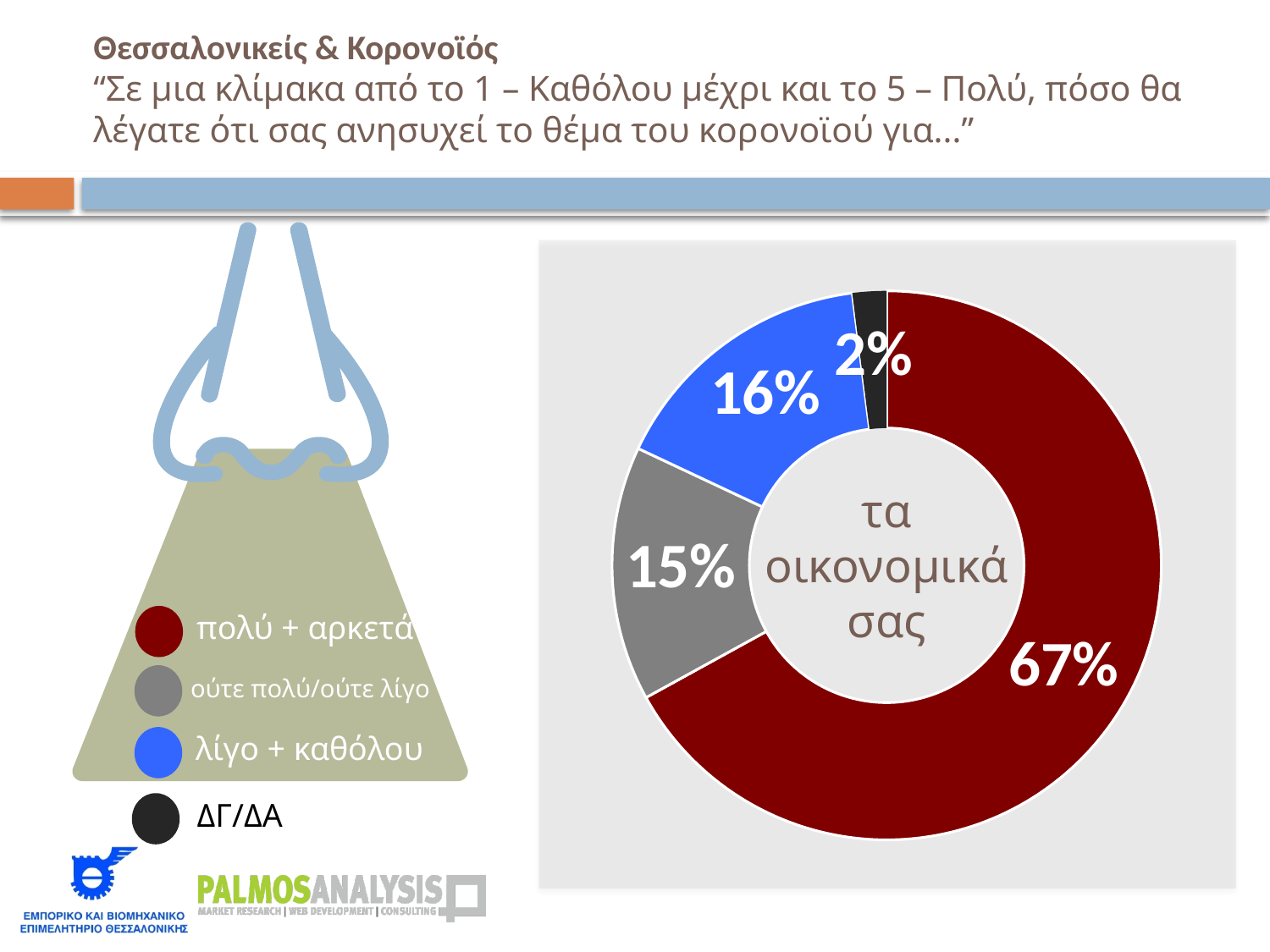
What percentage of respondents answered "πολύ + αρκετά" regarding concern about "τα οικονομικά σας"? 67% What colour represents the "λίγο + καθόλου" category in the chart? Blue What percentage of respondents answered "ΔΓ/ΔΑ"? 2% What type of chart is shown on the slide? Doughnut chart Which response category has the largest share of the doughnut chart? πολύ + αρκετά What is the difference in percentage points between "πολύ + αρκετά" and "λίγο + καθόλου"? 51 What percentage of respondents answered "λίγο + καθόλου"? 16% Which response category has the smallest share of the doughnut chart? ΔΓ/ΔΑ How many response categories are shown in the doughnut chart? 4 What percentage of respondents answered "ούτε πολύ/ούτε λίγο"? 15% Which is larger: the share for "λίγο + καθόλου" or the share for "ούτε πολύ/ούτε λίγο"? λίγο + καθόλου What topic is written in the centre of the doughnut chart? τα οικονομικά σας